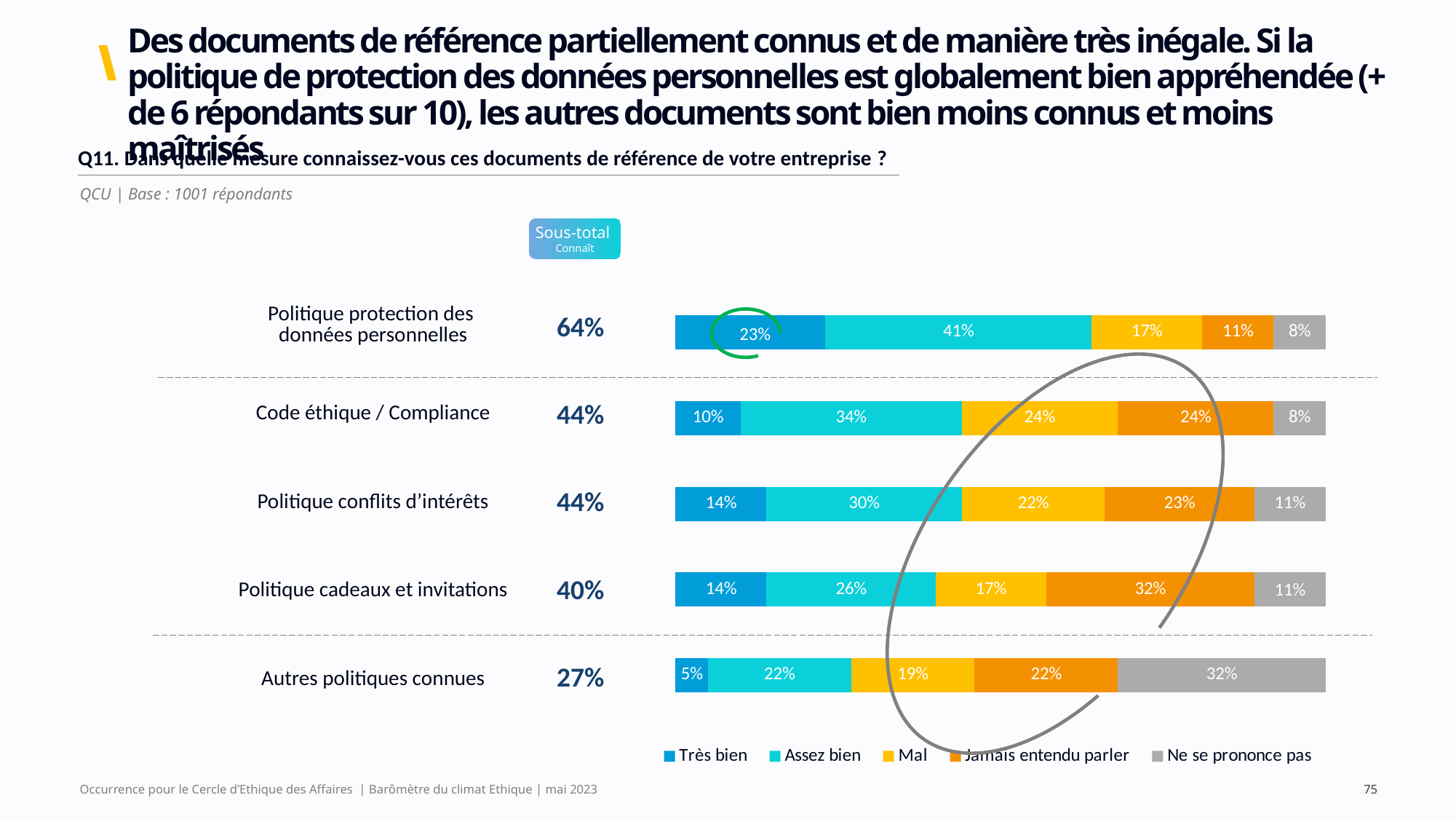
Which category has the lowest "Très bien" value? Autres politiques connues What percentage of respondents answered "Très bien" for "Politique protection des données personnelles"? 23% What is the "Sous-total Connaît" value shown for "Code éthique / Compliance"? 44% What is the "Ne se prononce pas" value for "Autres politiques connues"? 32% What is the sum of the "Très bien" and "Assez bien" values for "Politique conflits d'intérêts"? 44% Which is larger: the "Assez bien" value for "Politique conflits d'intérêts" or for "Politique cadeaux et invitations"? Politique conflits d'intérêts What is the difference between the "Mal" values for "Code éthique / Compliance" and "Politique cadeaux et invitations"? 7 percentage points How many series does the legend list? 5 Which category has the highest "Assez bien" value? Politique protection des données personnelles What kind of chart is shown on the slide? Stacked bar chart What is the "Jamais entendu parler" value for "Politique cadeaux et invitations"? 32% How many categories (documents) are shown in the chart? 5